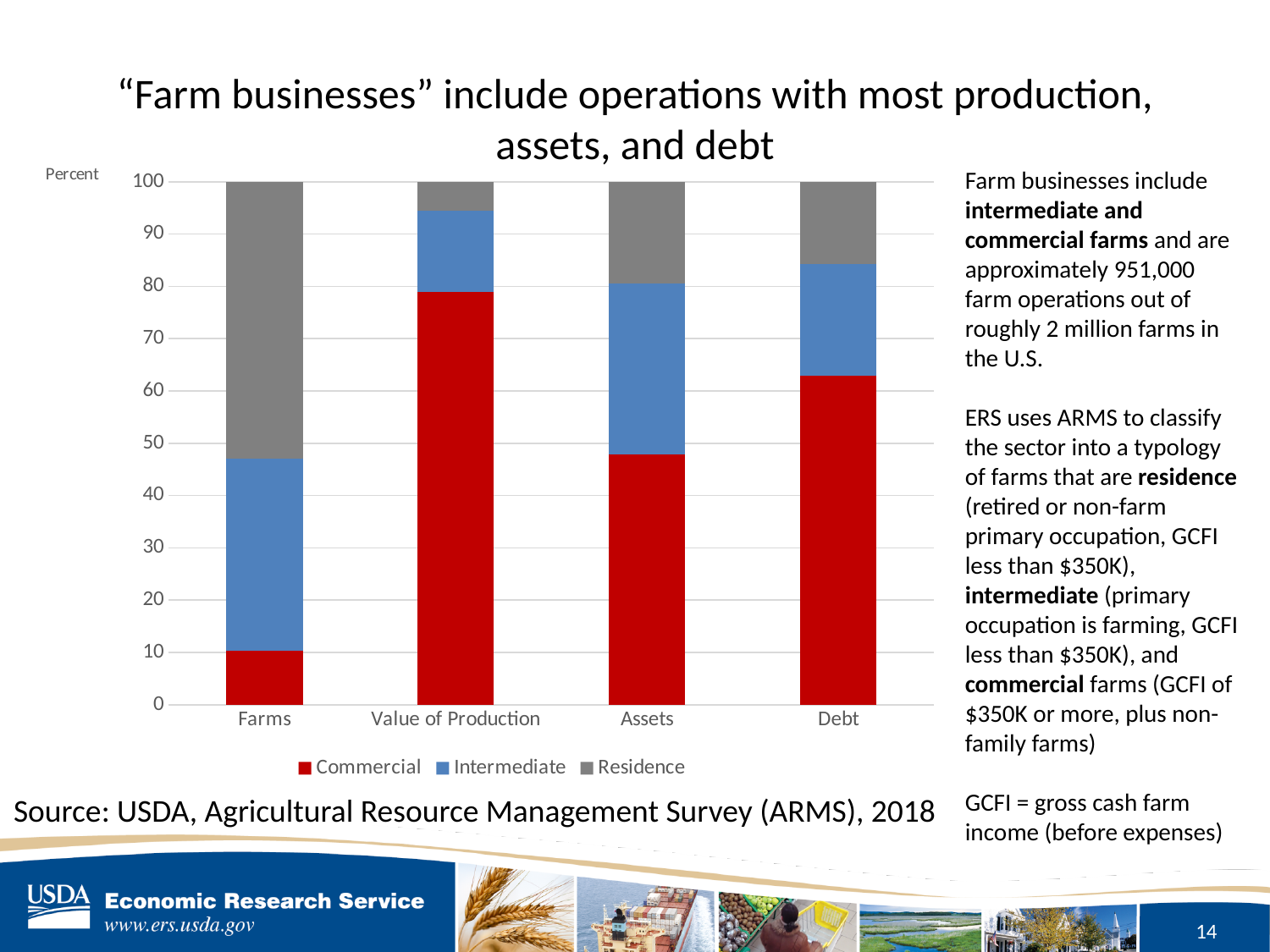
Is the Commercial value for Debt greater or less than 50? greater How many categories are shown on the x axis of the chart? 4 Which category has the smallest Commercial share? Farms Which category has the largest Commercial share? Value of Production What is the total of the stacked bar for Farms? 100 Is the Commercial value for Farms greater or less than 20? less How many series does the chart's legend list? 3 What kind of chart is shown on the slide? stacked bar chart Which category has the smallest Residence share? Value of Production Which category has the largest Residence share? Farms Which is larger, the Commercial share for Assets or the Commercial share for Debt? Debt What label is shown on the vertical axis of the chart? Percent